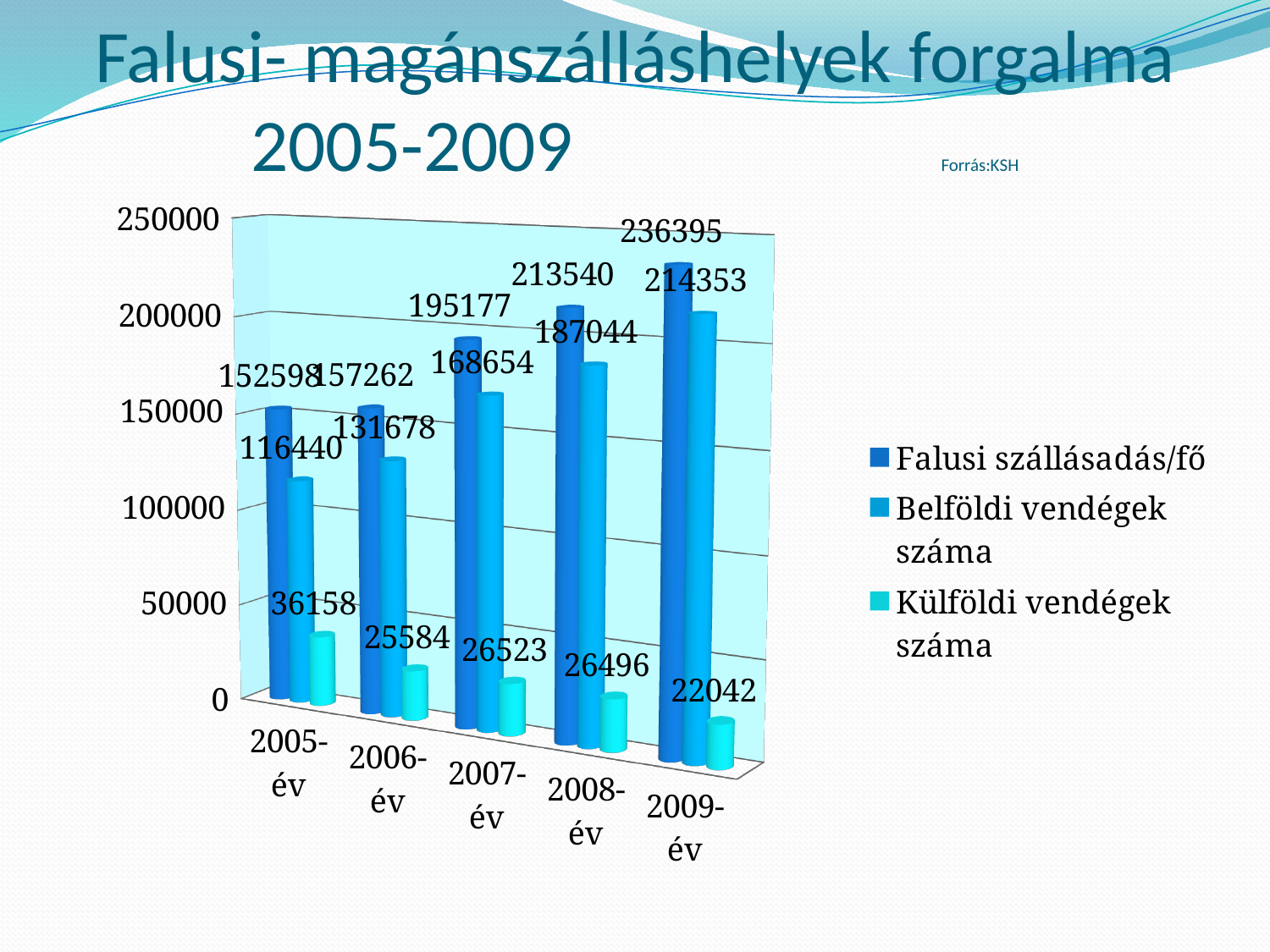
How many years are shown on the x axis? 5 What is the value of Külföldi vendégek száma for 2005-év? 36158 In which year is Külföldi vendégek száma lowest? 2009-év What is the value of Falusi szállásadás/fő for 2007-év? 195177 What kind of chart is shown on the slide? Bar chart How many series does the legend list? 3 What is the difference between Falusi szállásadás/fő and Belföldi vendégek száma in 2008-év? 26496 Does Belföldi vendégek száma rise or fall from 2005-év to 2009-év? Rise In which year is Falusi szállásadás/fő highest? 2009-év What is the value of Belföldi vendégek száma for 2009-év? 214353 What is the value of Belföldi vendégek száma for 2006-év? 131678 Which is larger: Külföldi vendégek száma in 2007-év or in 2008-év? 2007-év